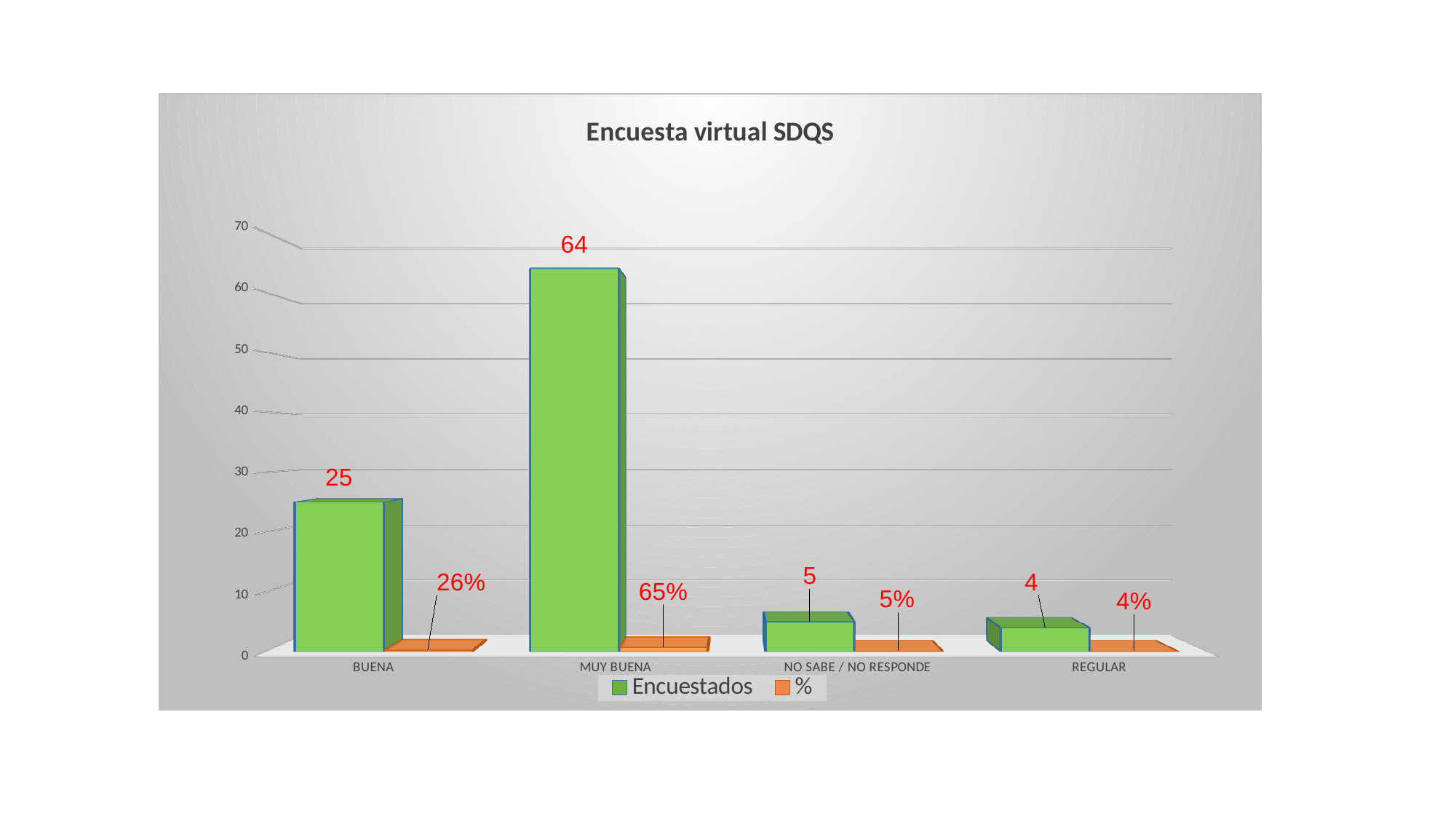
Which category has the highest Encuestados value? MUY BUENA Is the Encuestados value for MUY BUENA greater or less than 60? greater What is the Encuestados value for MUY BUENA? 64 What is the title of the chart? Encuesta virtual SDQS What is the Encuestados value for BUENA? 25 What is the % value for REGULAR? 4% Which category has the lowest Encuestados value? REGULAR How many categories are shown on the x axis? 4 Which is larger, the Encuestados value for NO SABE / NO RESPONDE or for REGULAR? NO SABE / NO RESPONDE How many series does the legend list? 2 What is the % value for NO SABE / NO RESPONDE? 5% What is the difference between the Encuestados values for MUY BUENA and BUENA? 39